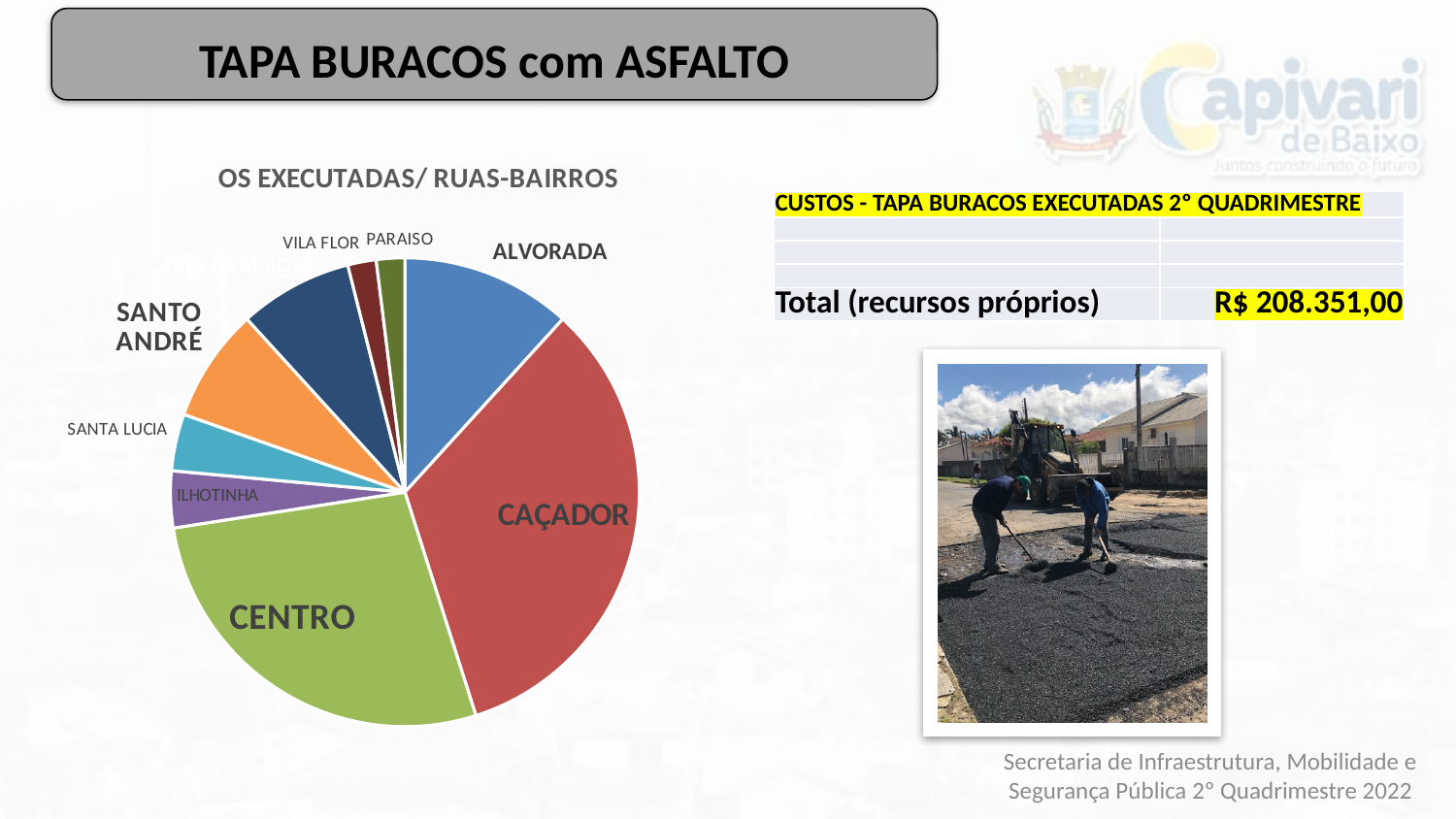
Which slice is larger in the pie chart, CENTRO or ALVORADA? CENTRO What kind of chart is shown on the slide? pie chart What colour is the CAÇADOR slice in the pie chart? red Which slice is larger in the pie chart, SANTO ANDRÉ or ILHOTINHA? SANTO ANDRÉ Which slice is larger in the pie chart, CAÇADOR or CENTRO? CAÇADOR Which category has the largest slice in the pie chart? CAÇADOR How many slices does the pie chart have? 9 What colour is the CENTRO slice in the pie chart? green